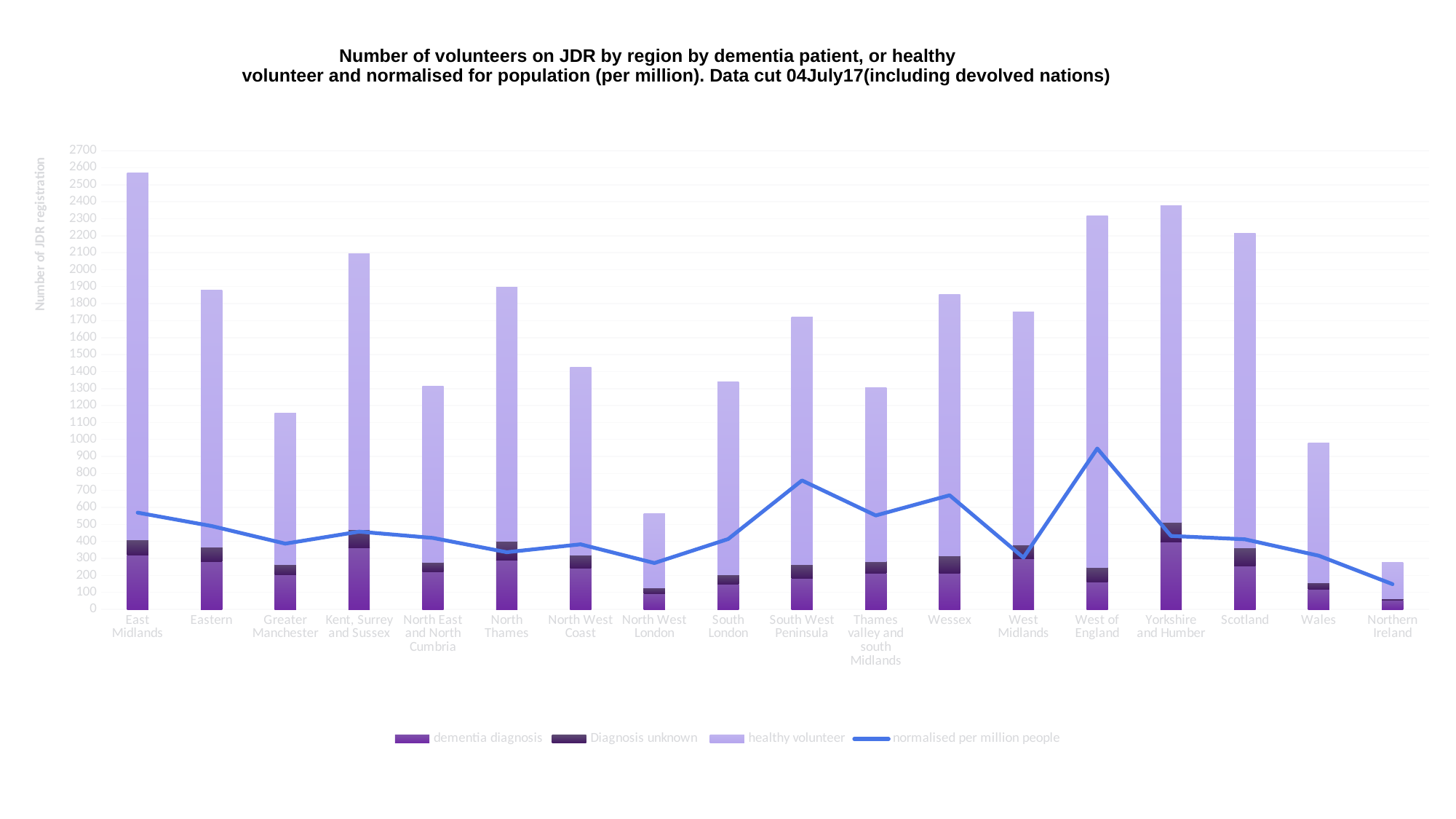
Does the normalised per million people line rise or fall from West of England to Northern Ireland? fall Which region has the highest value on the normalised per million people line? West of England How many regions are shown along the x axis? 18 Which region has the lowest value on the normalised per million people line? Northern Ireland What kind of chart is shown on the slide? stacked bar chart with a line Is the total stacked bar for East Midlands greater or less than 2000? greater Which region has the shortest stacked bar (lowest total number of JDR registrations)? Northern Ireland Which region has the tallest stacked bar (highest total number of JDR registrations)? East Midlands How many series does the legend list? 4 Which has the taller stacked bar, Kent, Surrey and Sussex or North Thames? Kent, Surrey and Sussex Which has the taller stacked bar, Scotland or Wales? Scotland Is the total stacked bar for North West London greater or less than 600? less